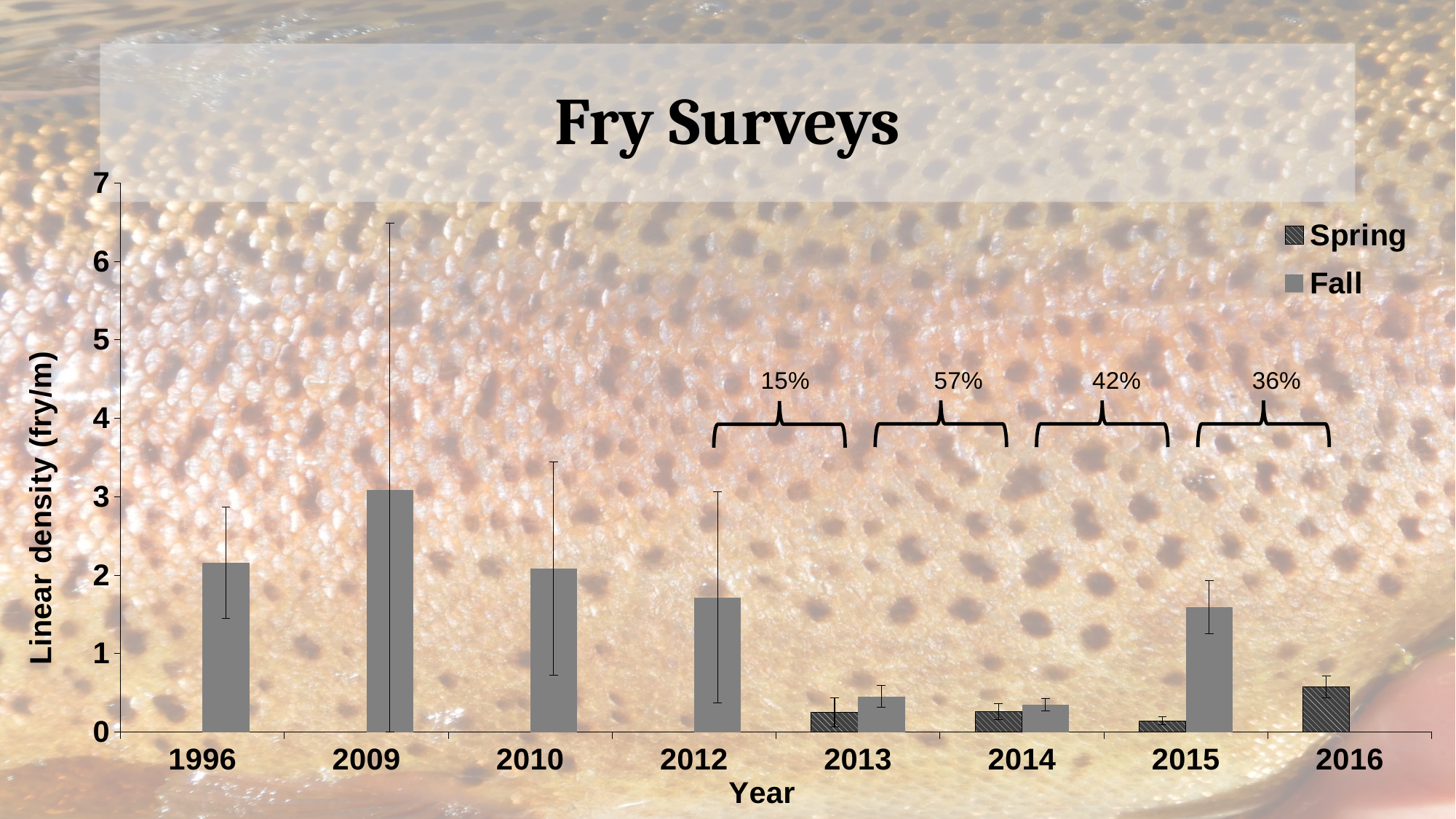
What kind of chart is shown on the slide? bar chart Is the Fall value for 2009 greater or less than 2? greater Is the Fall value for 2015 greater or less than 1? greater How many series does the legend list? 2 In 2015, which series has the larger value, Spring or Fall? Fall Which year has the highest Fall linear density? 2009 Which year has the lowest Spring linear density? 2015 How many years are shown on the x axis? 8 Is the Fall value for 2012 greater or less than 2? less Do the Fall values rise or fall from 2009 to 2014? fall Which is larger, the Fall value for 2009 or the Fall value for 2010? 2009